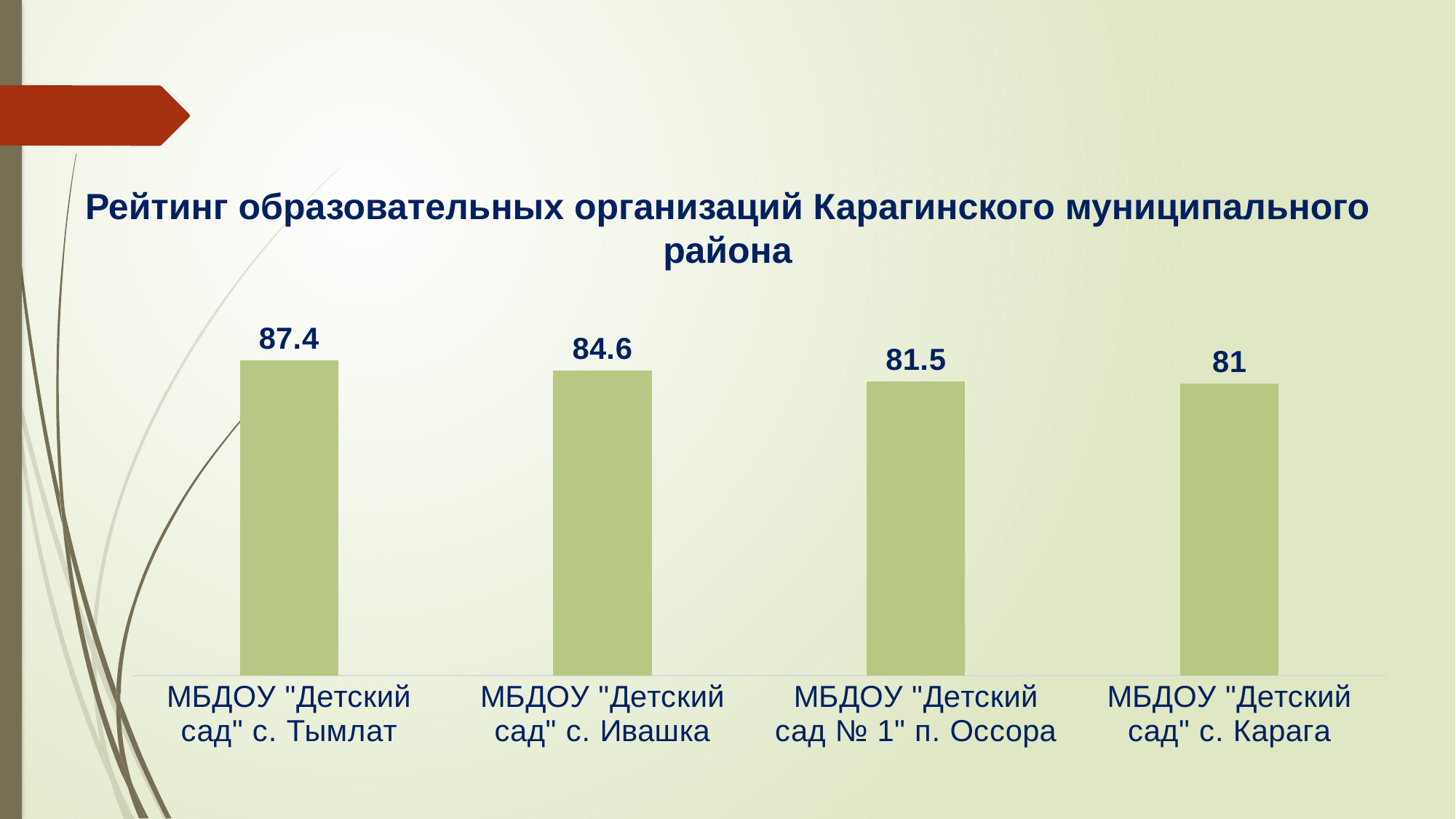
Which organisation has the lowest value? МБДОУ "Детский сад" с. Карага Which is larger, the value for с. Ивашка or the value for п. Оссора? с. Ивашка What is the value for МБДОУ "Детский сад" с. Карага? 81 Which organisation has the highest value? МБДОУ "Детский сад" с. Тымлат What is the value for МБДОУ "Детский сад" с. Ивашка? 84.6 What is the difference between the values for с. Ивашка and п. Оссора? 3.1 What kind of chart is shown on the slide? bar chart What is the value for МБДОУ "Детский сад № 1" п. Оссора? 81.5 Do the values rise or fall from left to right across the chart? fall What is the value for МБДОУ "Детский сад" с. Тымлат? 87.4 What is the difference between the values for с. Тымлат and с. Карага? 6.4 How many organisations are shown in the chart? 4